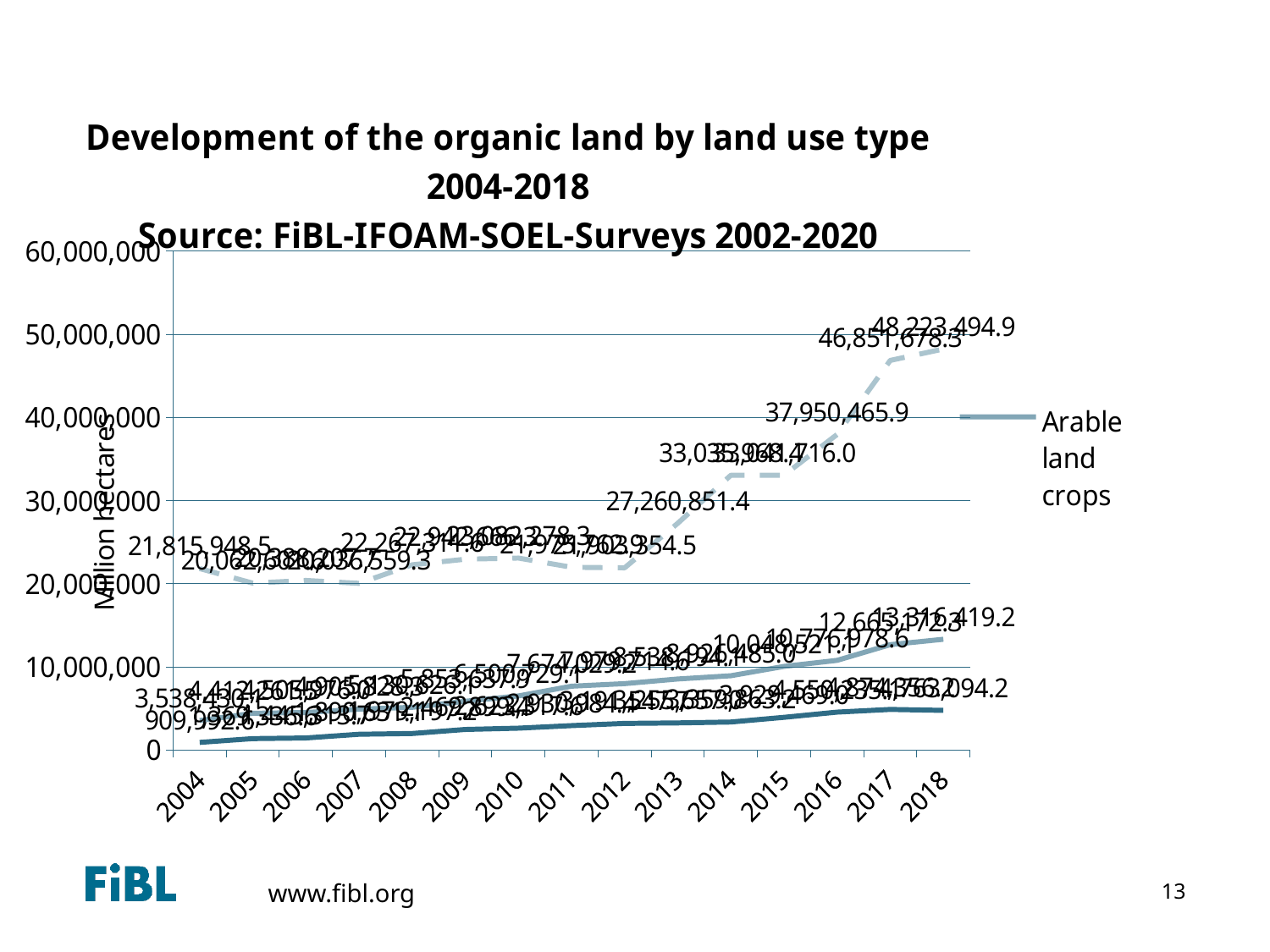
Does the topmost (dashed) line rise or fall between 2013 and 2018? rise By how much did the topmost (dashed) line increase from 2017 to 2018? 1,371,816.6 What is the value of the topmost (dashed) line in 2018? 48,223,494.9 Is the value of the topmost (dashed) line in 2018 greater or less than 40,000,000? greater What kind of chart is shown on the slide? line chart What is the label on the vertical axis? Million hectares In which year does the topmost (dashed) line reach its highest value? 2018 What is the value of the topmost (dashed) line in 2013? 27,260,851.4 How many years are plotted along the x axis? 15 What is the value of the topmost (dashed) line in 2017? 46,851,678.3 Which is larger for the topmost (dashed) line: the 2013 value or the 2016 value? 2016 What is the value of the topmost (dashed) line in 2016? 37,950,465.9